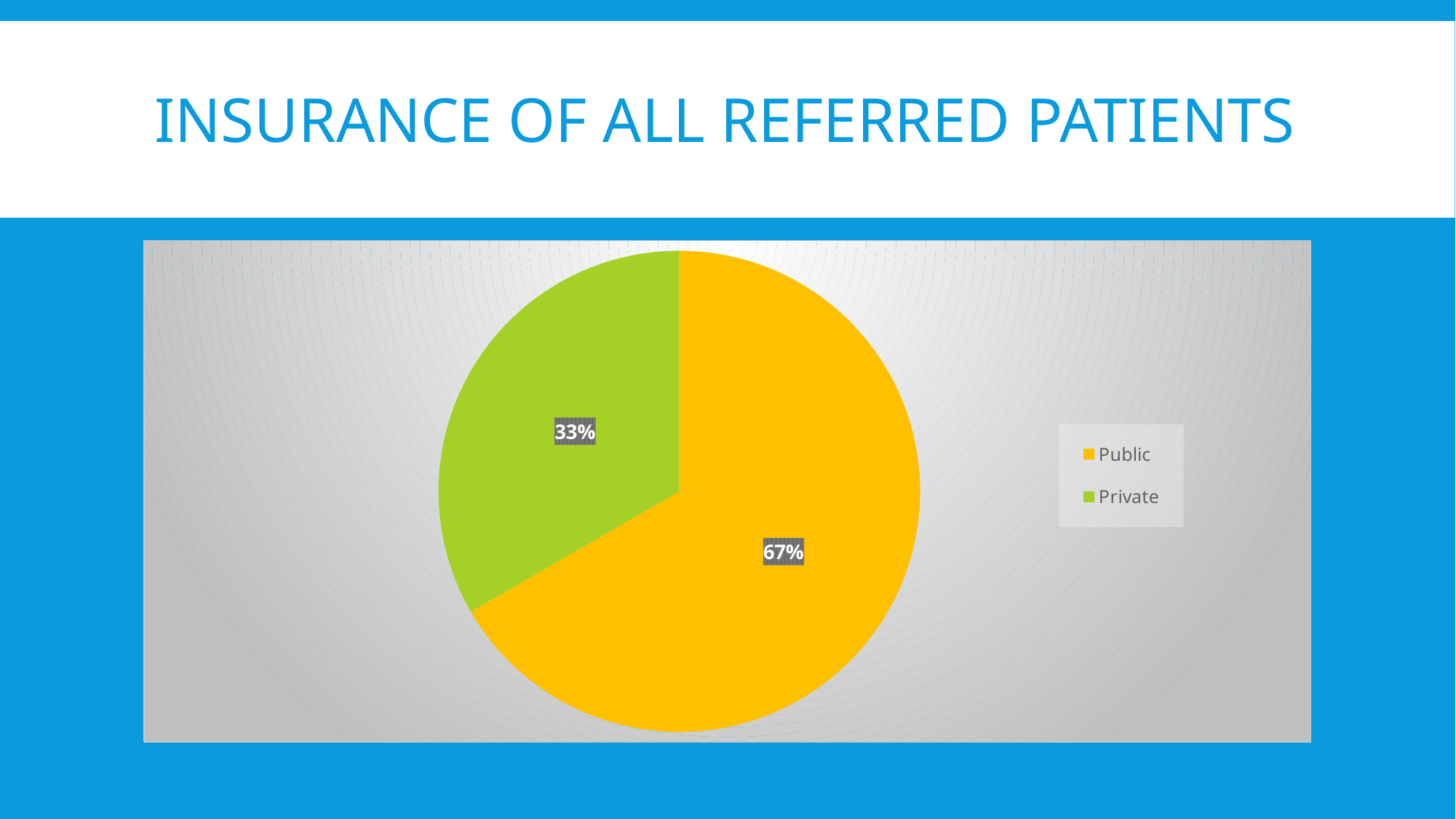
Which insurance category has the smallest share of the pie? Private How many entries does the legend list? 2 Which is larger, the Public share or the Private share? Public What is the difference in percentage points between the Public and Private shares? 34 What share of referred patients have Private insurance? 33% What colour is the Private slice of the pie? green Which insurance category has the largest share of the pie? Public What share of referred patients have Public insurance? 67% What is the title of the slide containing the chart? INSURANCE OF ALL REFERRED PATIENTS What kind of chart is shown on the slide? pie chart How many slices does the pie chart have? 2